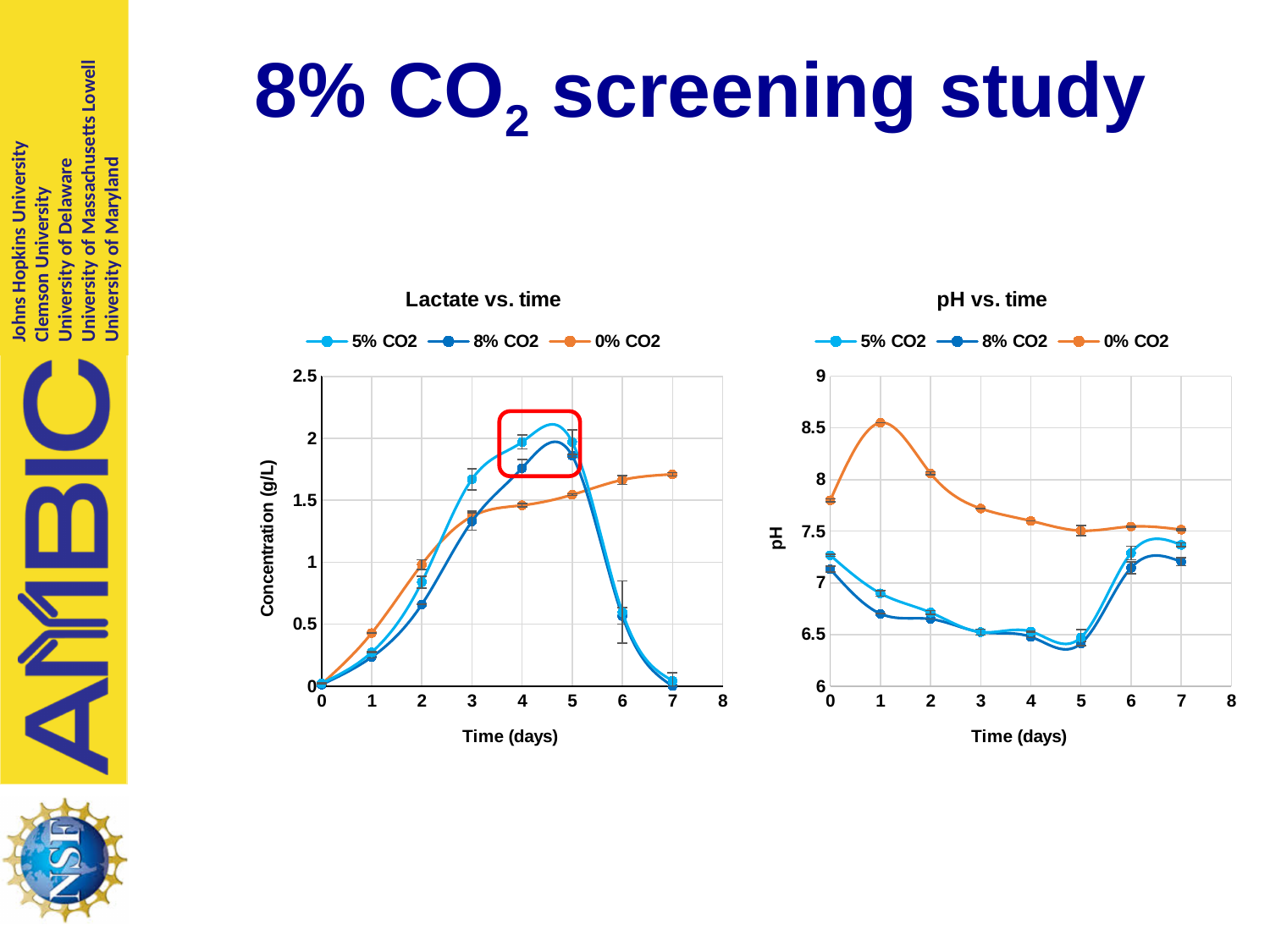
What is the y-axis label of the 'Lactate vs. time' chart? Concentration (g/L) In the 'Lactate vs. time' chart, is the value for 5% CO2 at day 7 greater or less than 0.5? less In the 'pH vs. time' chart, is the value for 8% CO2 at day 1 greater or less than 7? less In the 'pH vs. time' chart, does the 0% CO2 series rise or fall from day 1 to day 5? fall What kind of chart is the 'Lactate vs. time' chart? line chart In the 'Lactate vs. time' chart, is the value for 0% CO2 at day 7 greater or less than 1.5? greater In the 'Lactate vs. time' chart, which series has the larger value at day 6, 0% CO2 or 5% CO2? 0% CO2 How many series does the legend of the 'pH vs. time' chart list? 3 In the 'pH vs. time' chart, which series has the larger value at day 7, 0% CO2 or 8% CO2? 0% CO2 In the 'pH vs. time' chart, which series has the highest pH at day 1? 0% CO2 What are the legend entries of the 'Lactate vs. time' chart? 5% CO2, 8% CO2, 0% CO2